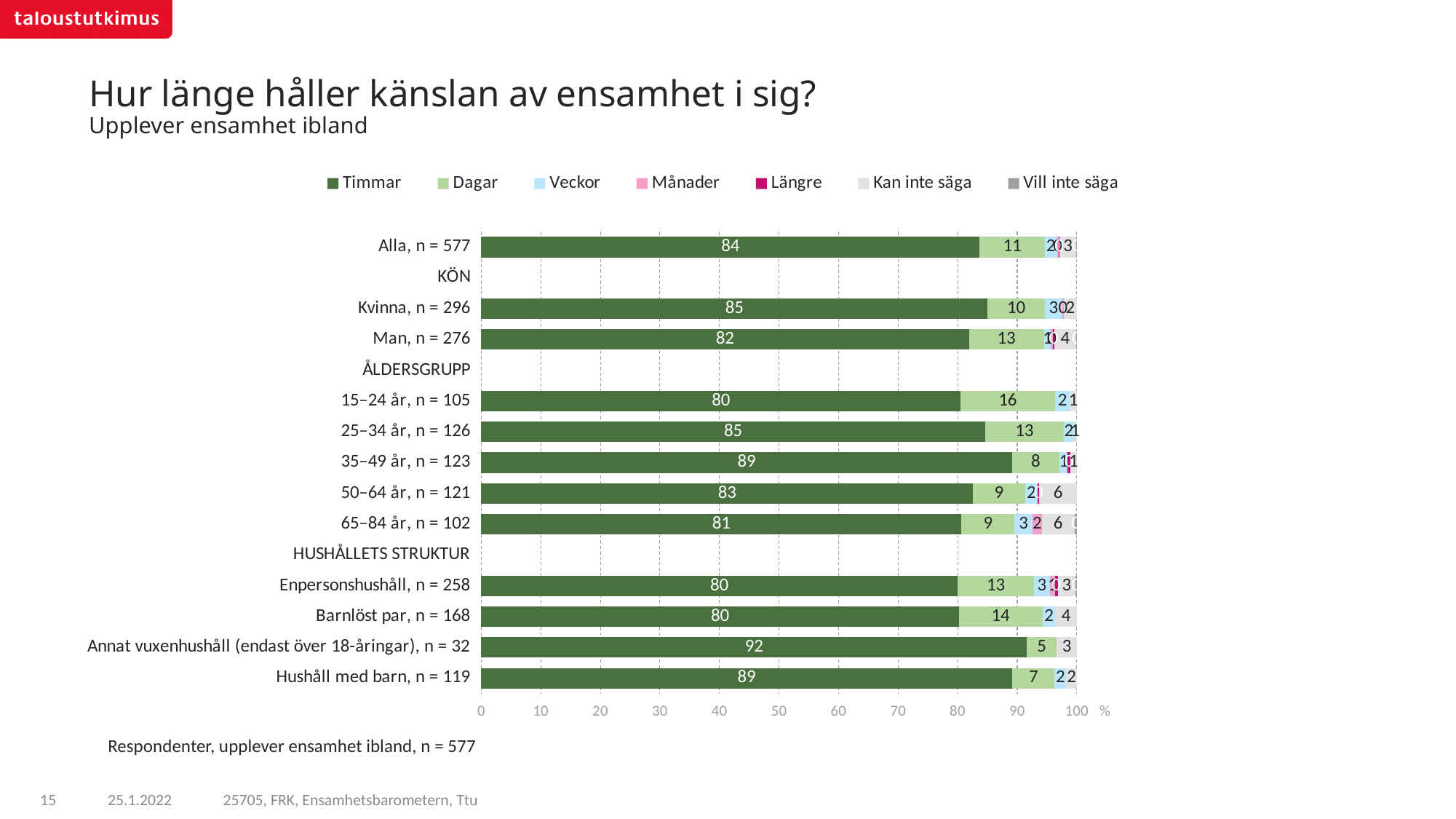
What type of chart is shown on the slide? Stacked bar chart What is the Dagar value for 15–24 år, n = 105? 16 What is the Timmar value for Annat vuxenhushåll (endast över 18-åringar), n = 32? 92 Which group has the highest Timmar value? Annat vuxenhushåll (endast över 18-åringar), n = 32 What is the difference between the Timmar values for Kvinna, n = 296 and Man, n = 276? 3 What is the title of the chart? Hur länge håller känslan av ensamhet i sig? What is the Timmar value for Alla, n = 577? 84 Which group has the lowest Dagar value? Annat vuxenhushåll (endast över 18-åringar), n = 32 Which has a larger Dagar value: Barnlöst par, n = 168 or Hushåll med barn, n = 119? Barnlöst par, n = 168 Is the Timmar value for 35–49 år, n = 123 greater or less than 80? greater What is the Dagar value for Man, n = 276? 13 How many series does the legend list? 7